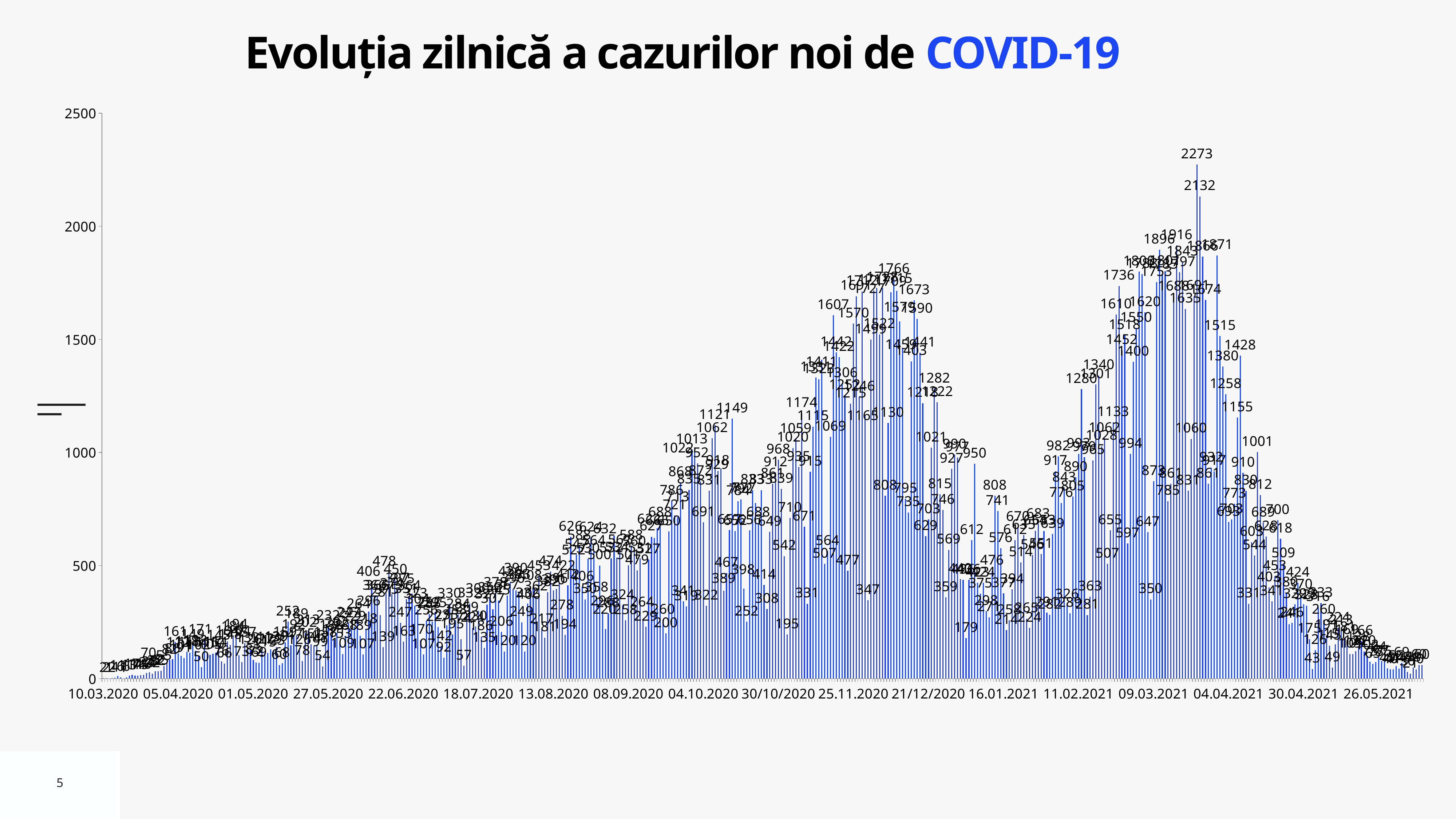
Are the bars at the start of the period, around 10.03.2020, greater or less than 500? less What is the second-highest daily value labelled on the chart, next to the 2273 peak? 2132 What is the highest value labelled in the wave around 25.11.2020? 1766 Is the highest bar on the chart greater or less than 2000? greater What is the highest daily value labelled on the chart? 2273 What is the title of the chart? Evoluția zilnică a cazurilor noi de COVID-19 What is the difference between the two highest labelled values, 2273 and 2132? 141 Which is higher: the peak of the wave around 04.04.2021 or the peak of the wave around 25.11.2020? the peak around 04.04.2021 What is the first date label on the horizontal axis? 10.03.2020 What is the last date label on the horizontal axis? 26.05.2021 What is the maximum value shown on the vertical axis? 2500 What kind of chart is shown on the slide? bar chart